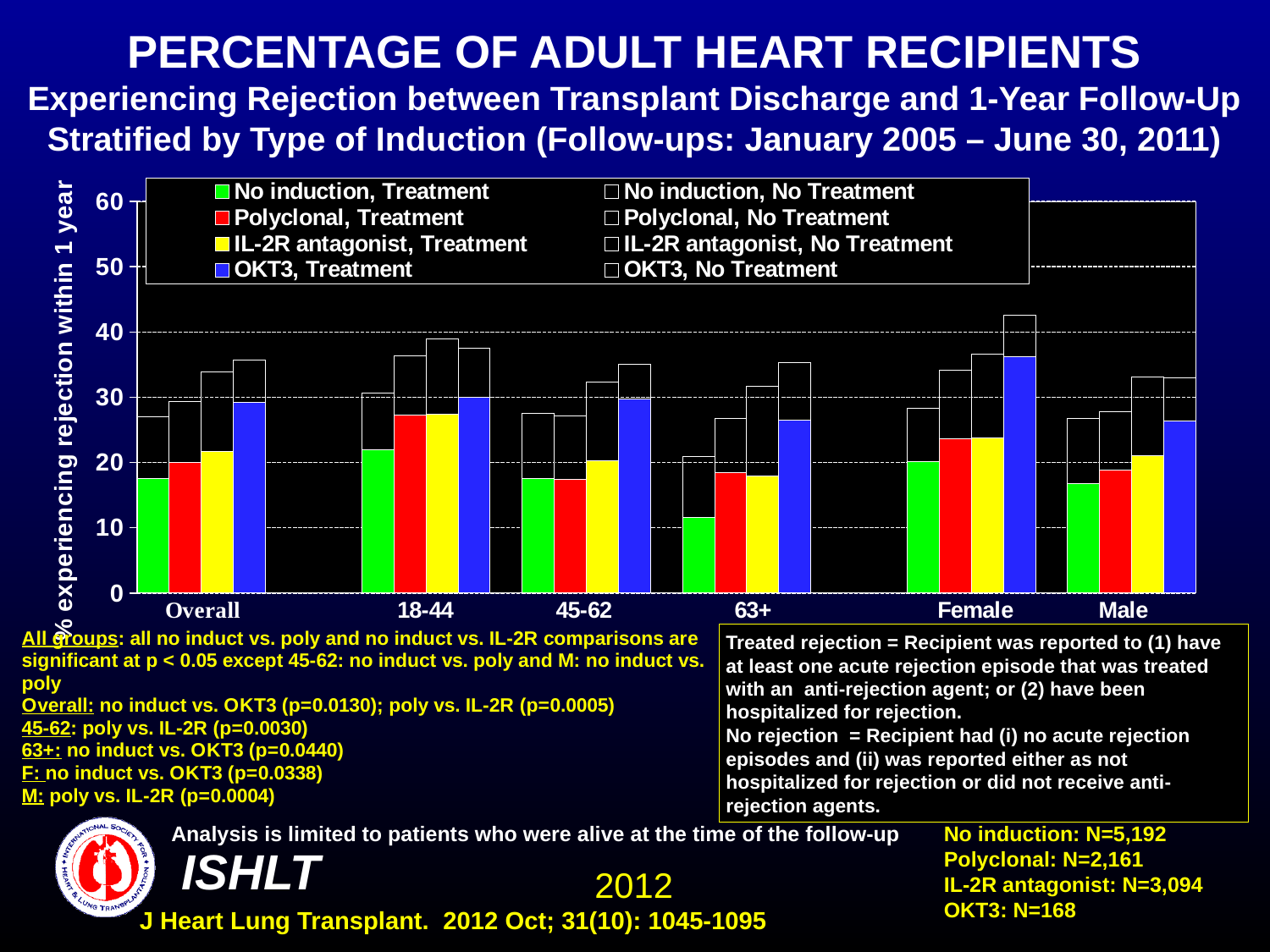
What is the label of the y axis of the chart? % experiencing rejection within 1 year Which category has the lowest 'No induction, Treatment' value? 63+ Is the 'OKT3, Treatment' value for the Female group greater or less than 30? greater Is the total height of the OKT3 stacked bar for the Female group greater or less than 40? greater Is the 'No induction, Treatment' value for the 63+ group greater or less than 20? less What kind of chart is shown on the slide? Stacked bar chart In the Overall group, which is larger: the 'OKT3, Treatment' value or the 'No induction, Treatment' value? OKT3, Treatment How many series does the chart legend list? 8 Which category has the highest 'OKT3, Treatment' value? Female How many categories are shown along the x axis of the chart? 6 What colour represents the 'OKT3, Treatment' series in the chart? Blue